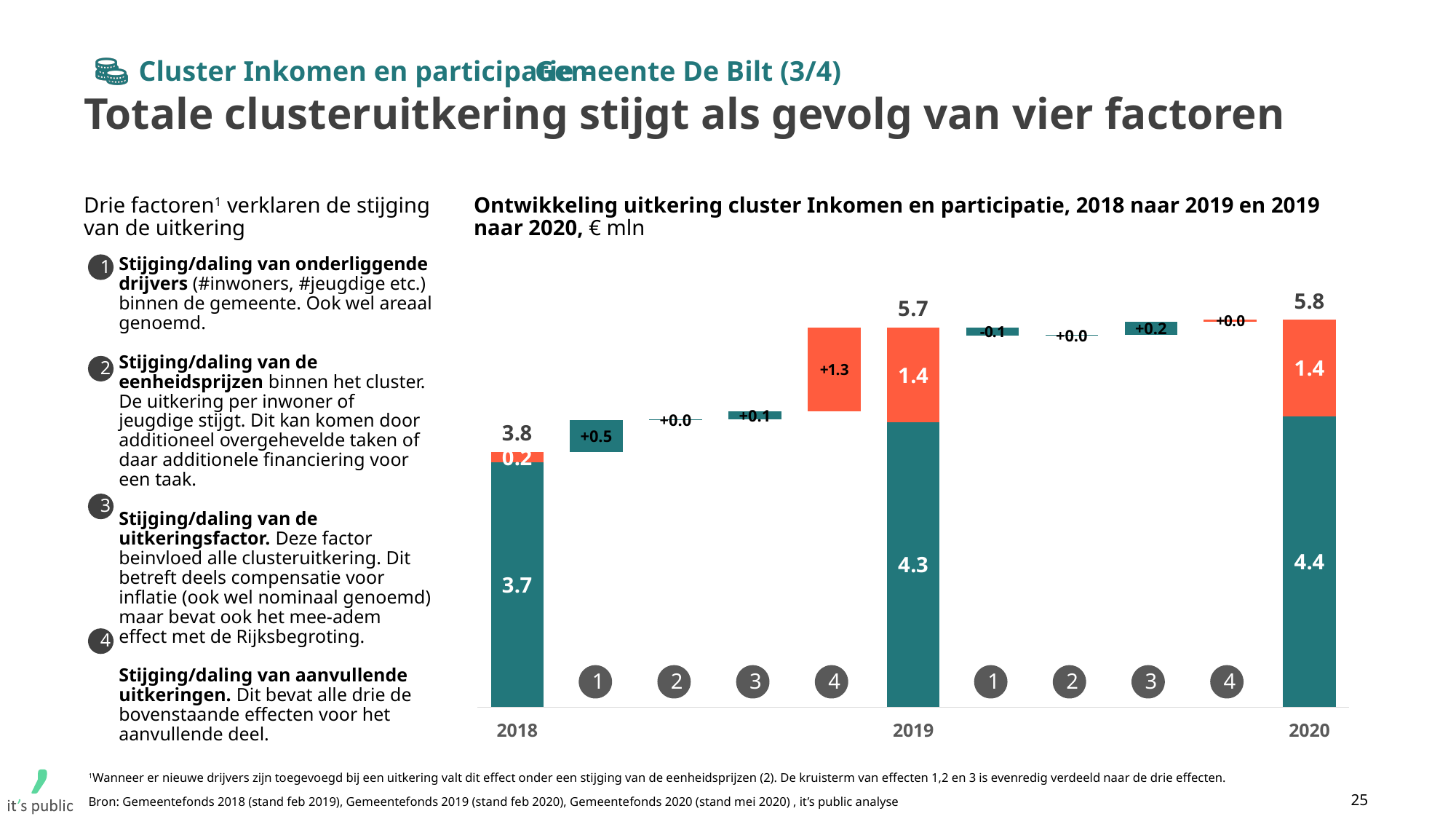
What is the total cluster payment shown for 2018? 3.8 In what unit are the values in the chart expressed? € mln By how much does the total cluster payment increase from 2018 to 2019? 1.9 What is the total cluster payment shown for 2020? 5.8 What is the value of the teal (lower) segment of the 2019 bar? 4.3 Do the total cluster payments rise or fall from 2018 to 2020? rise What is the value of the orange (upper) segment of the 2020 bar? 1.4 What is the effect of factor 4 in the step from 2018 to 2019? +1.3 Which year has the highest total cluster payment? 2020 What is the effect of factor 1 in the step from 2019 to 2020? -0.1 What is the total cluster payment shown for 2019? 5.7 Which factor has the largest effect in the step from 2018 to 2019? 4